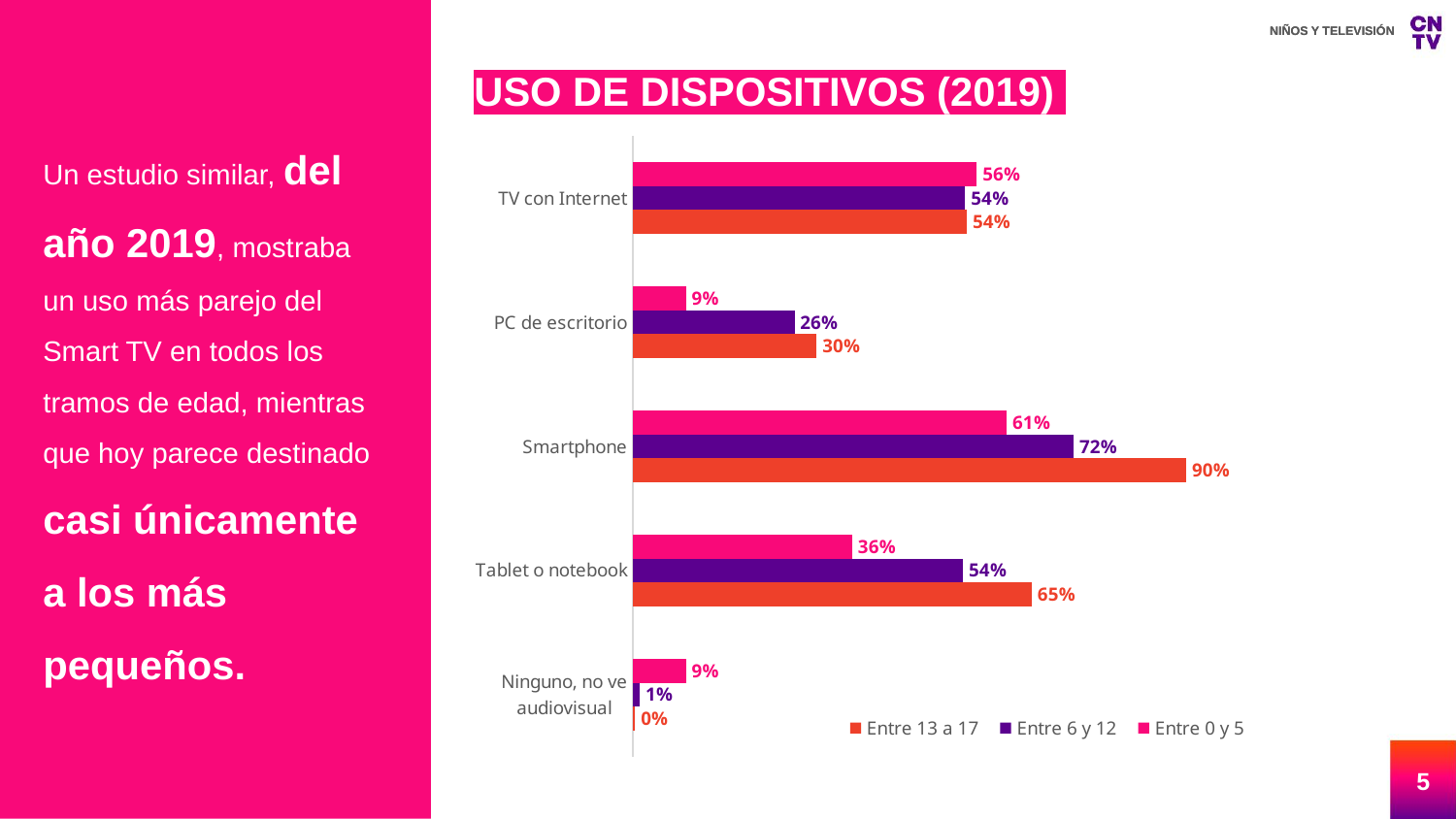
How many series does the legend list? 3 What is the value for Tablet o notebook in the Entre 6 y 12 series? 54% What is the difference between the Entre 13 a 17 and Entre 0 y 5 values for Smartphone? 29% What is the value for PC de escritorio in the Entre 0 y 5 series? 9% How many device categories are shown on the chart? 5 Which category has the highest value in the Entre 13 a 17 series? Smartphone What is the value for Ninguno, no ve audiovisual in the Entre 13 a 17 series? 0% Which category has the lowest value in the Entre 6 y 12 series? Ninguno, no ve audiovisual What kind of chart is shown on the slide? Bar chart What is the title of the chart? USO DE DISPOSITIVOS (2019) For Tablet o notebook, which series has the larger value: Entre 13 a 17 or Entre 0 y 5? Entre 13 a 17 What is the value for Smartphone in the Entre 13 a 17 series? 90%